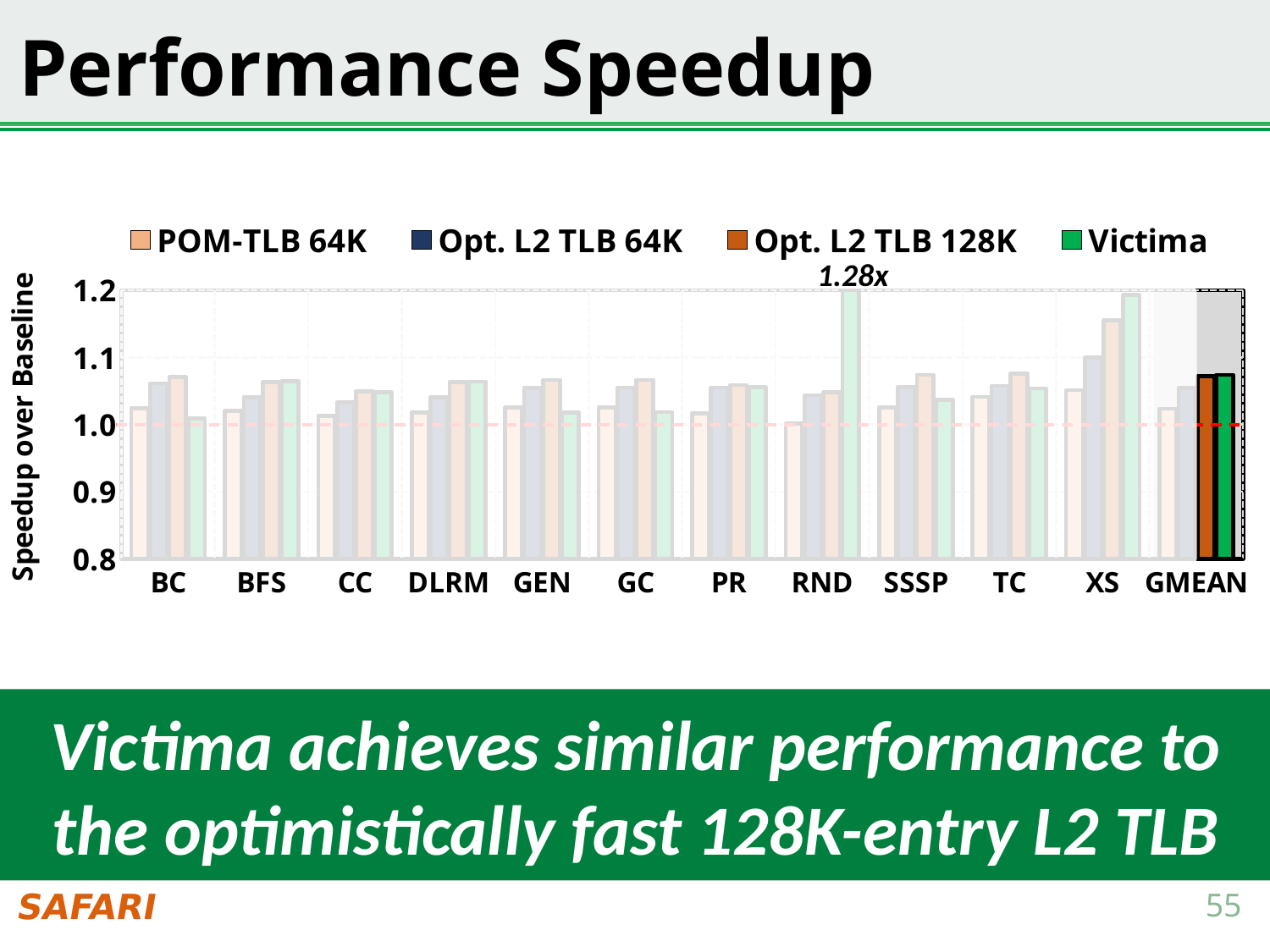
Is the POM-TLB 64K value for BC greater or less than 1.1? less Which category has the highest Victima speedup? RND For BC, which is larger: the Opt. L2 TLB 128K value or the Victima value? Opt. L2 TLB 128K For XS, which is larger: the Victima value or the POM-TLB 64K value? Victima What is the Victima speedup for RND? 1.28x What kind of chart is shown on the slide? bar chart What is the title of the y axis? Speedup over Baseline Is the Victima value for XS greater or less than 1.1? greater How many series does the legend list? 4 How many categories are shown along the x axis? 12 Which legend entry is shown in green? Victima Is the Opt. L2 TLB 128K value for XS greater or less than 1.1? greater